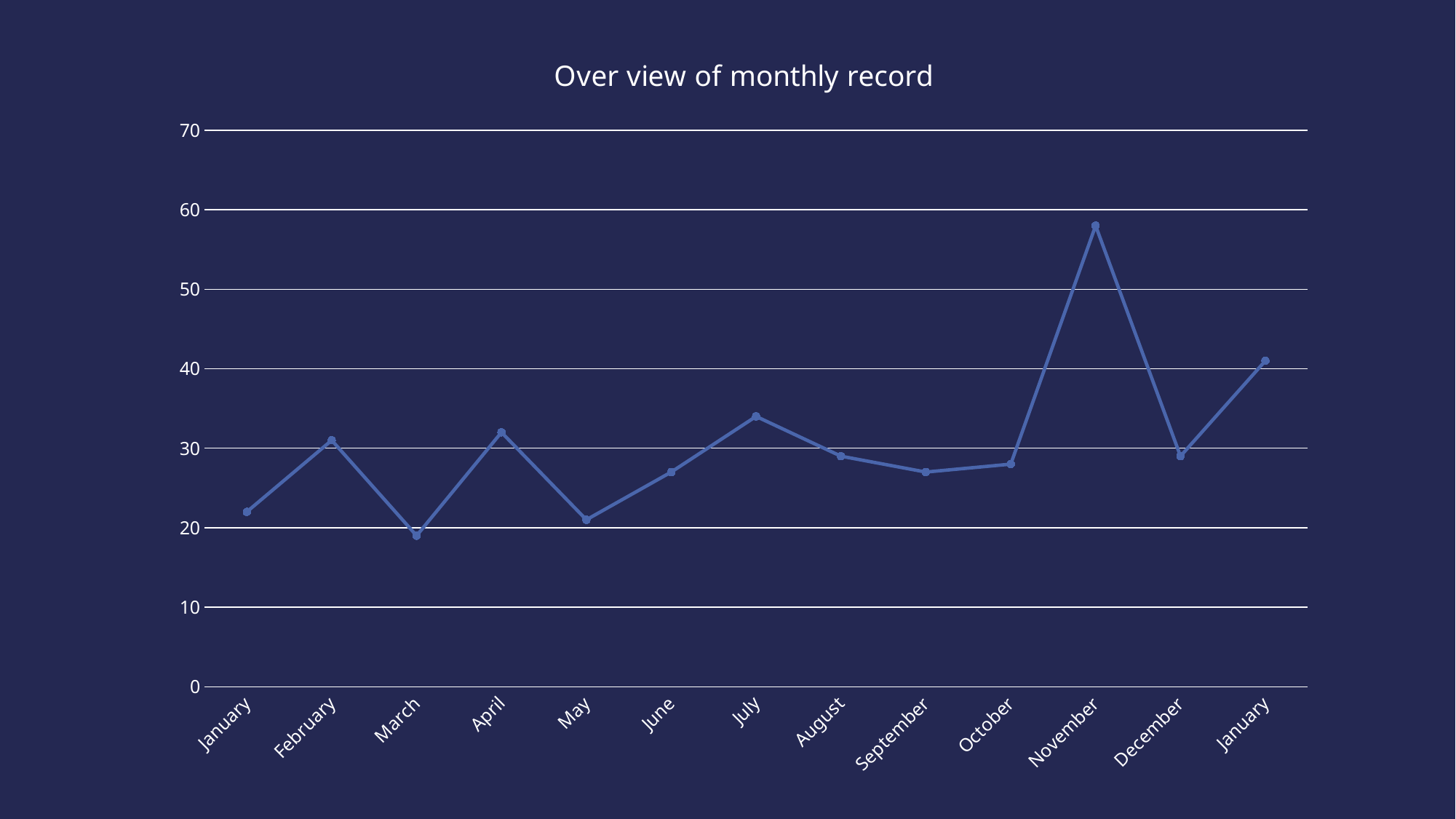
Which month has the highest value? November Is the value for June greater or less than 30? less What is the title of the chart? Over view of monthly record Which is larger, the value for November or the value for December? November Is the value for July greater or less than 30? greater Which is larger, the value for July or the value for May? July Does the line rise or fall from November to December? fall What kind of chart is shown on the slide? line chart Is the value for March greater or less than 20? less How many data points are plotted on the line? 13 Which month has the lowest value? March